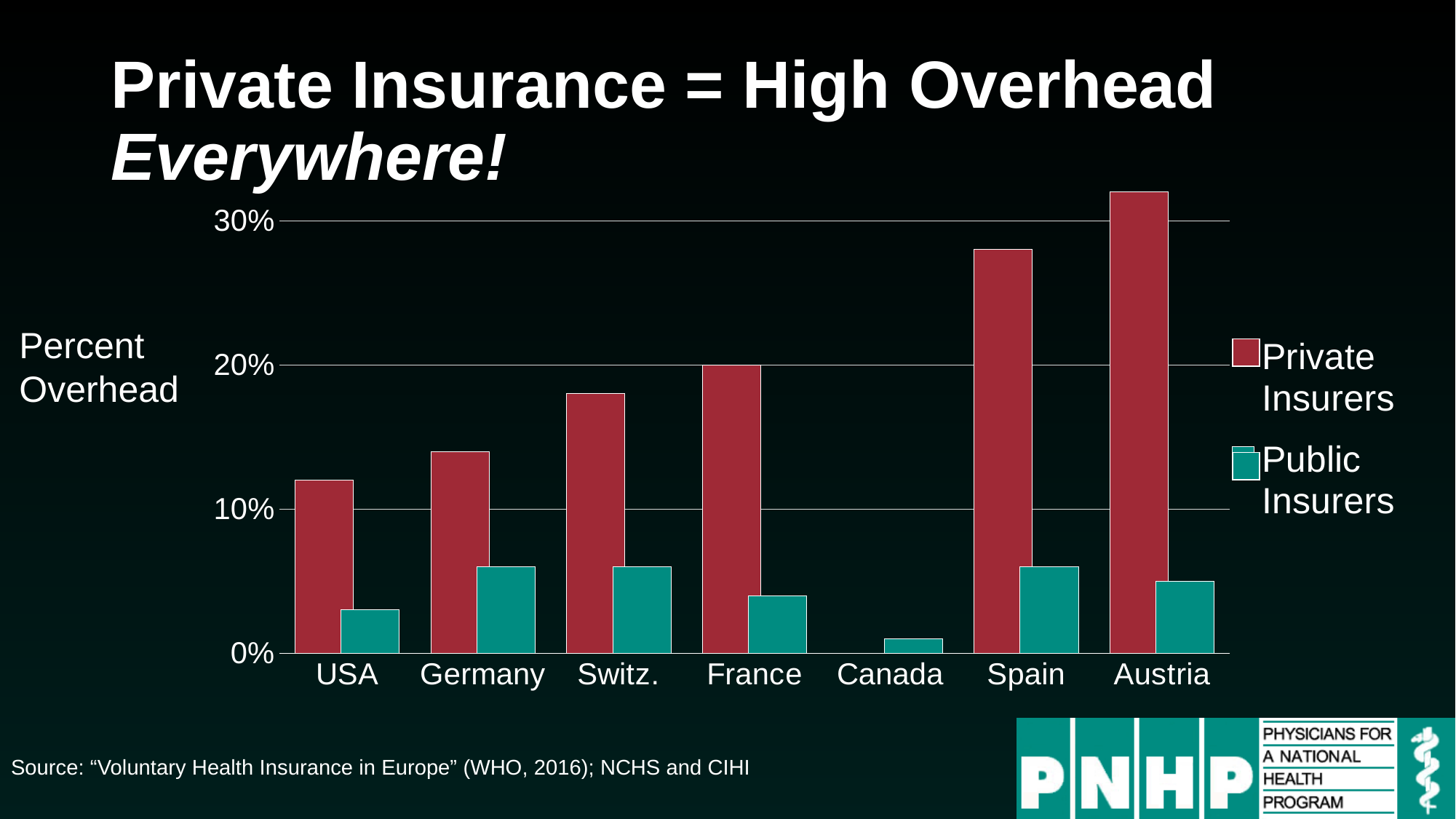
Is the Private Insurers value for Austria greater or less than 30%? greater How many series does the legend list? 2 Is the Private Insurers value for Spain greater or less than 20%? greater Is the Private Insurers value for USA greater or less than 10%? greater What kind of chart is shown on the slide? bar chart Which is larger for France: the Private Insurers value or the Public Insurers value? Private Insurers How many countries are shown on the x axis? 7 What is the label on the y axis of the chart? Percent Overhead Which country has the lowest Public Insurers overhead? Canada Which country has a larger Private Insurers value, Germany or Switz.? Switz. Which country has the highest Private Insurers overhead? Austria